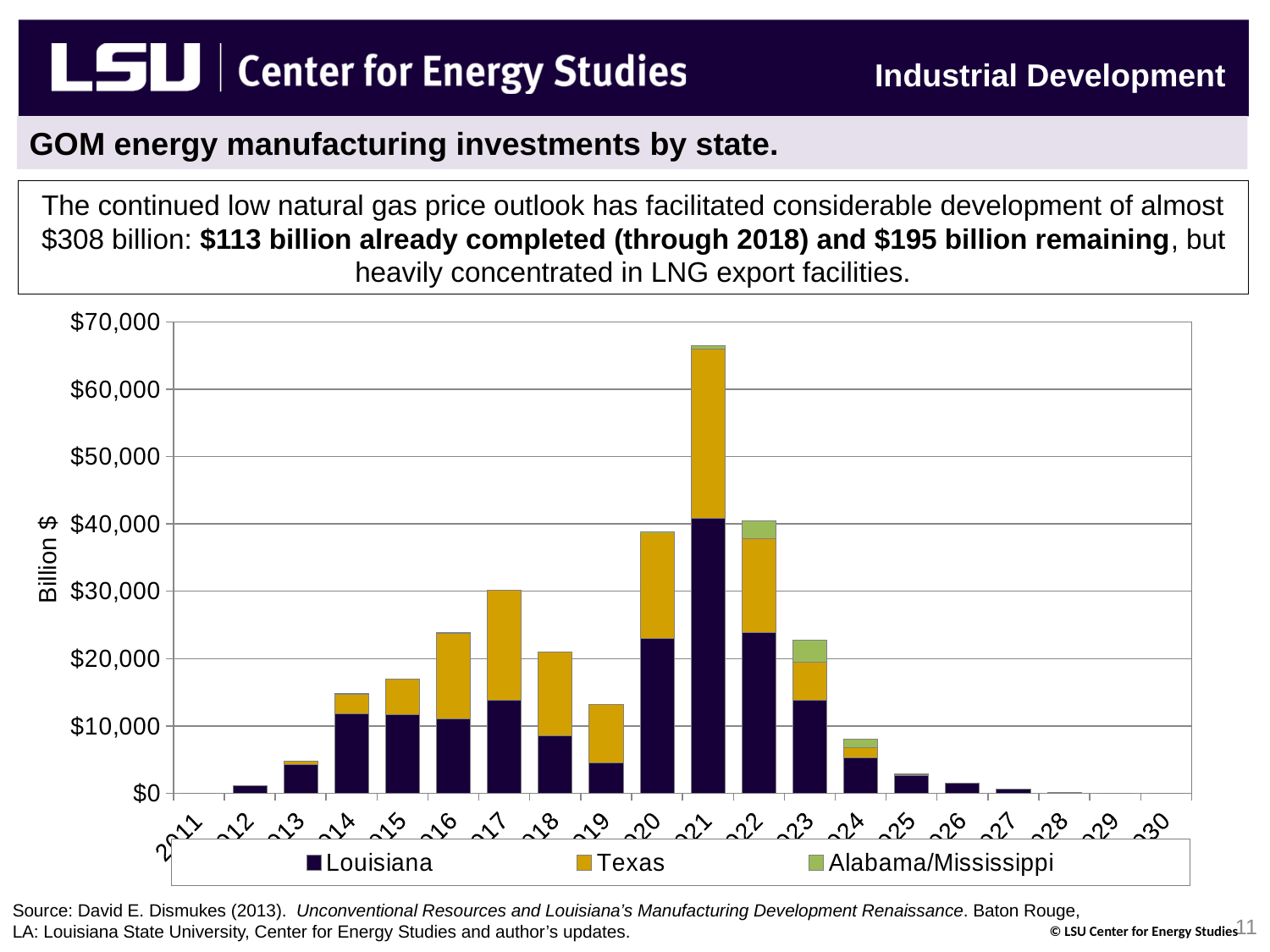
Do the total values rise or fall from 2021 to 2026? fall How many years are shown on the x axis? 20 Is the Louisiana value for 2021 greater or less than $30,000? greater What kind of chart is shown on the slide? Stacked bar chart Which year has the tallest stacked bar? 2021 Is the total value for 2024 greater or less than $10,000? less What is the label on the vertical axis? Billion $ Is the total value for 2020 greater or less than $30,000? greater How many series does the legend list? 3 Which year has the larger total bar, 2019 or 2020? 2020 Which series are listed in the legend? Louisiana, Texas, Alabama/Mississippi